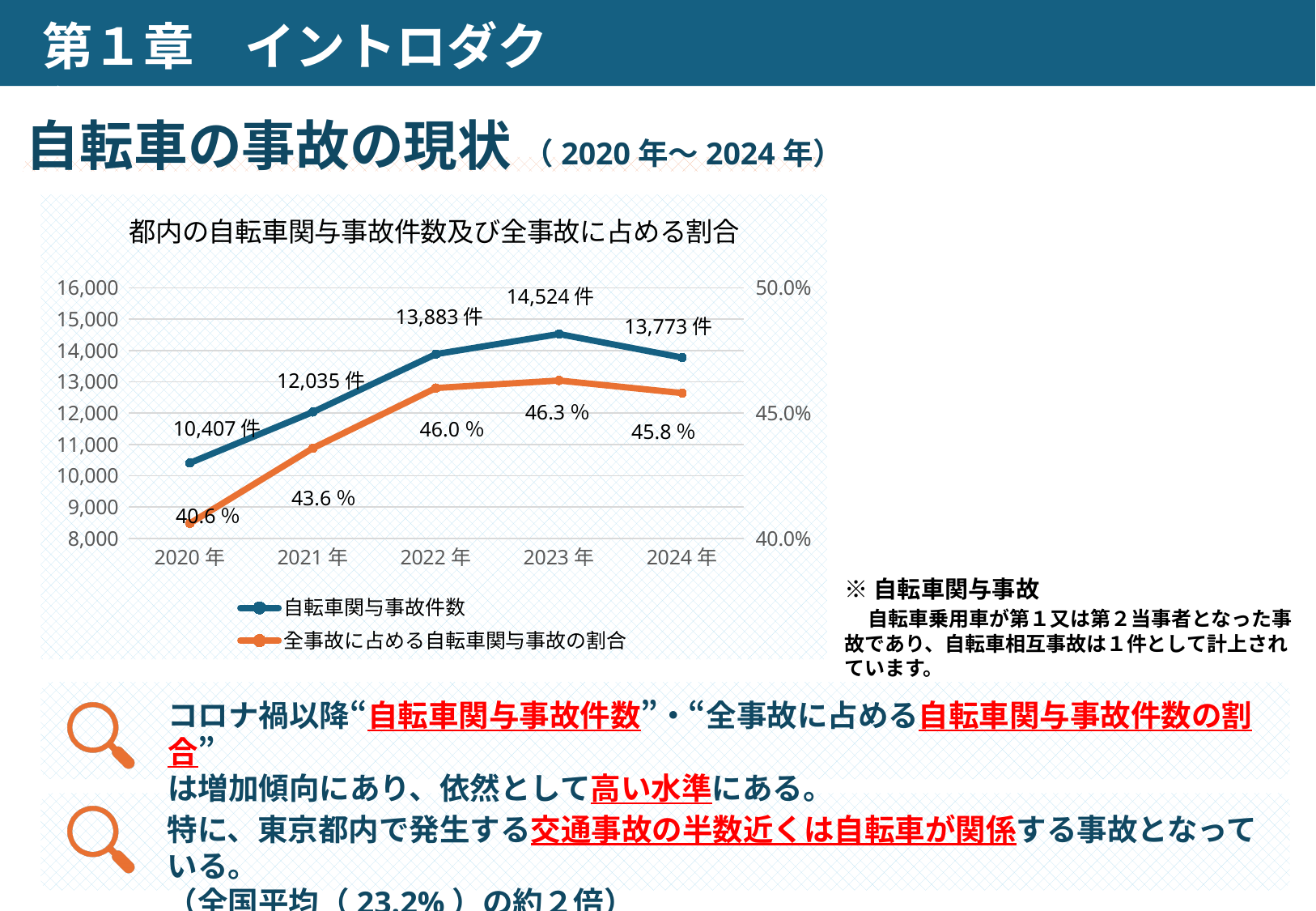
What type of chart is shown on the slide? Line chart What is the value of 自転車関与事故件数 for 2024年? 13,773件 What is the difference in 自転車関与事故件数 between 2023年 and 2022年? 641件 What is the title of the chart? 都内の自転車関与事故件数及び全事故に占める割合 How does 自転車関与事故件数 change from 2020年 to 2023年? It rises What is the value of 自転車関与事故件数 for 2020年? 10,407件 In which year is 自転車関与事故件数 highest? 2023年 How many series does the chart legend list? 2 In which year is 全事故に占める自転車関与事故の割合 lowest? 2020年 What is the value of 全事故に占める自転車関与事故の割合 for 2023年? 46.3% Which year has a larger 全事故に占める自転車関与事故の割合, 2021年 or 2022年? 2022年 How many years are plotted on the x axis of the chart? 5